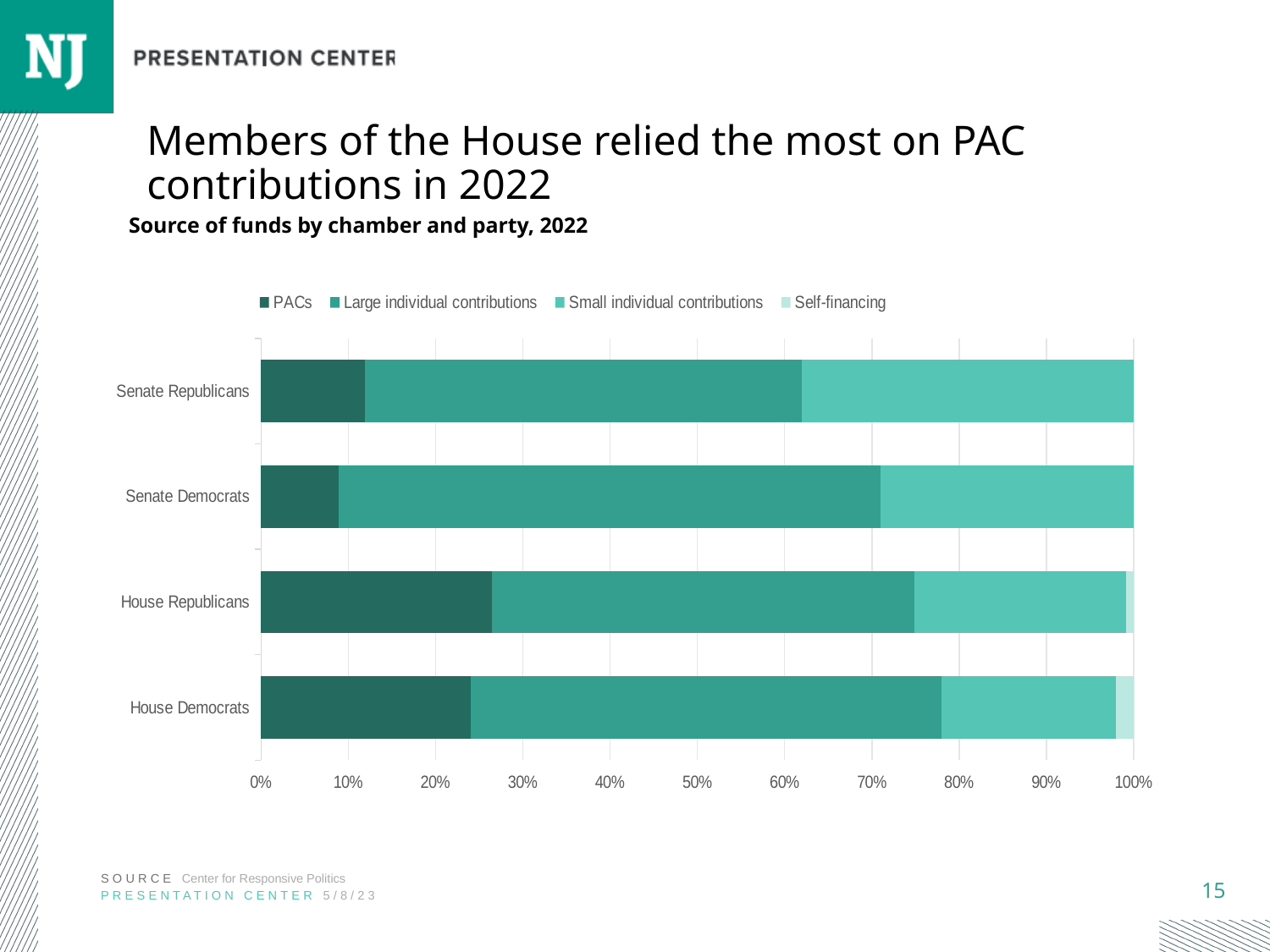
Which has a larger PACs share, Senate Republicans or Senate Democrats? Senate Republicans What is the subtitle of the chart? Source of funds by chamber and party, 2022 Is the PACs share for Senate Democrats greater or less than 10%? less How many categories (chamber-party groups) are plotted on the chart? 4 What are the four series listed in the legend? PACs, Large individual contributions, Small individual contributions, Self-financing What kind of chart is shown on the slide? Stacked bar chart Which has a larger PACs share, House Republicans or Senate Republicans? House Republicans What is the total of the Senate Republicans stacked bar? 100% How many series does the legend list? 4 Which category has the smallest PACs share? Senate Democrats Is the PACs share for Senate Republicans greater or less than 10%? greater Is the PACs share for House Republicans greater or less than 20%? greater